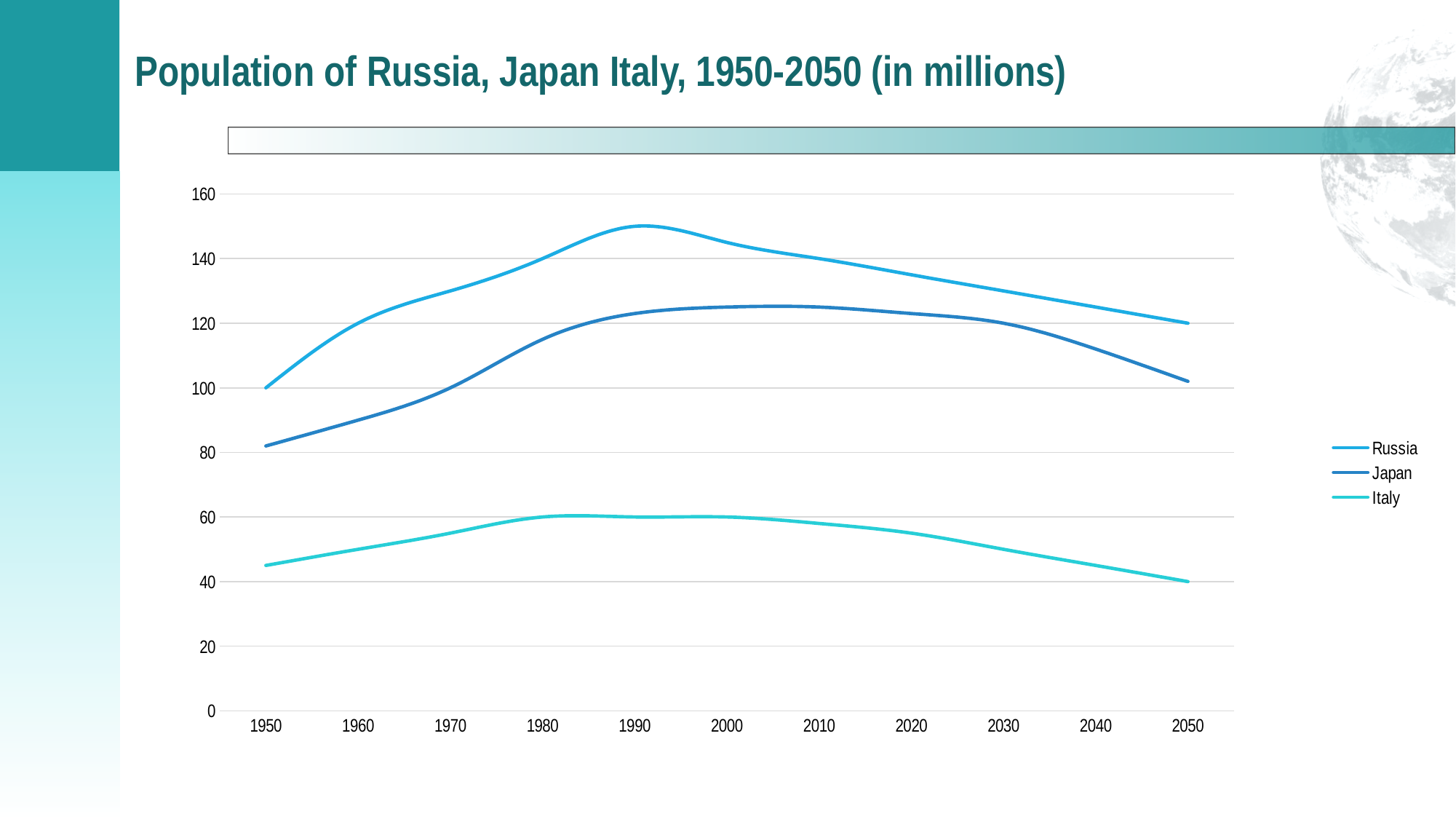
Does the population of Italy rise or fall from 2000 to 2050? fall How many series does the legend list? 3 Is the value for Italy in 1950 greater or less than 40? greater How many years are marked along the x axis? 11 Which country has the lowest population in 1950? Italy Is the value for Russia in 1990 greater or less than 140? greater What is the population of Russia in 1950? 100 Is the value for Japan in 2000 greater or less than 120? greater What kind of chart is shown on the slide? line chart What is the population of Italy in 2050? 40 What is the population of Russia in 2050? 120 Which country has the highest population in 2050? Russia